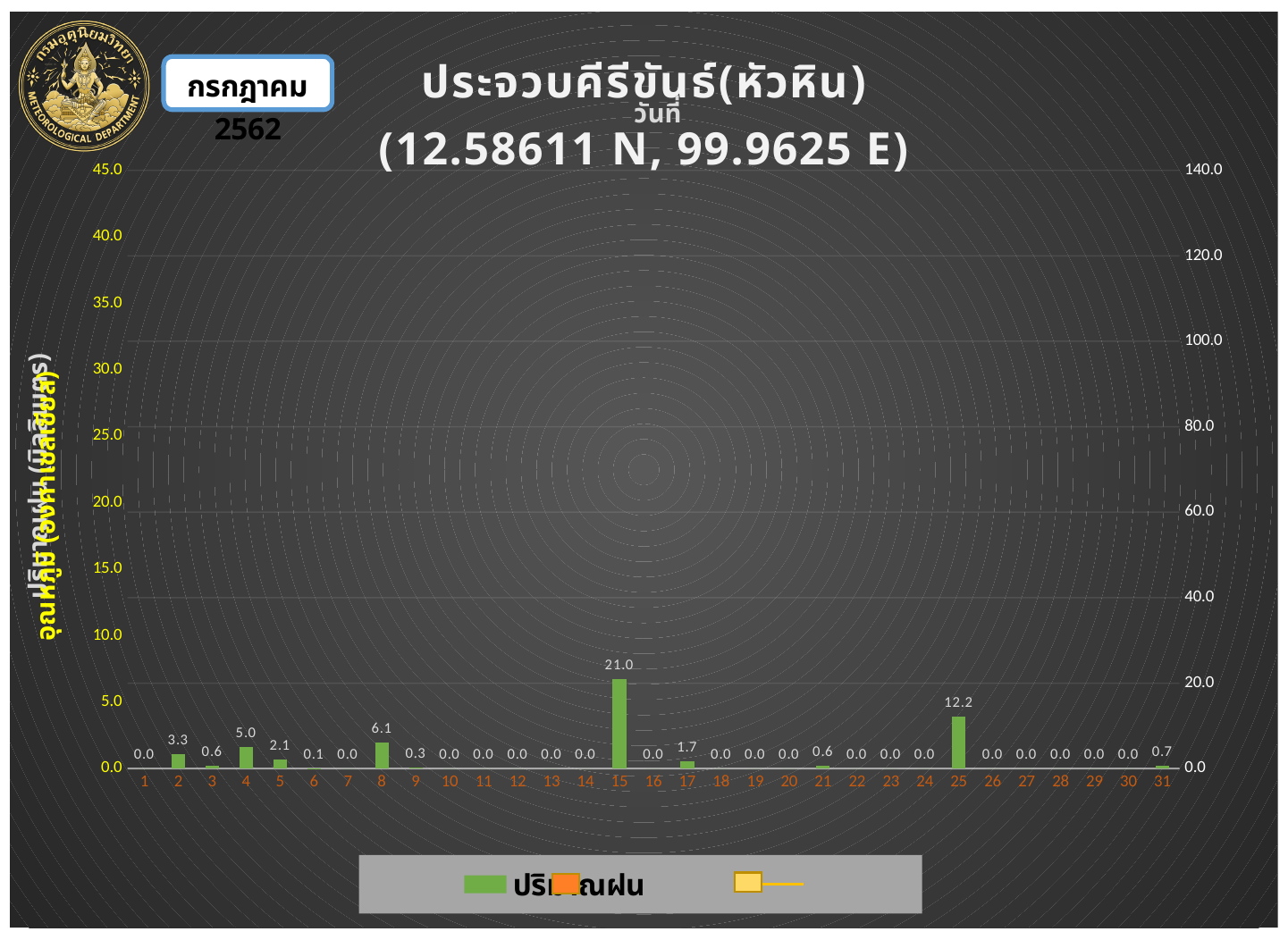
What kind of chart is shown on the slide? bar chart What is the rainfall value shown for day 8? 6.1 Which day has the highest rainfall value? 15 What is the difference between the rainfall values for day 8 and day 4? 1.1 What is the difference between the rainfall values for day 15 and day 25? 8.8 What is the rainfall value shown for day 31? 0.7 What is the rainfall value shown for day 15? 21.0 What is the highest value shown on the left y axis? 45.0 How many days are shown on the x axis? 31 Which has a larger rainfall value, day 2 or day 5? day 2 What is the rainfall value shown for day 25? 12.2 What is the rainfall value shown for day 4? 5.0